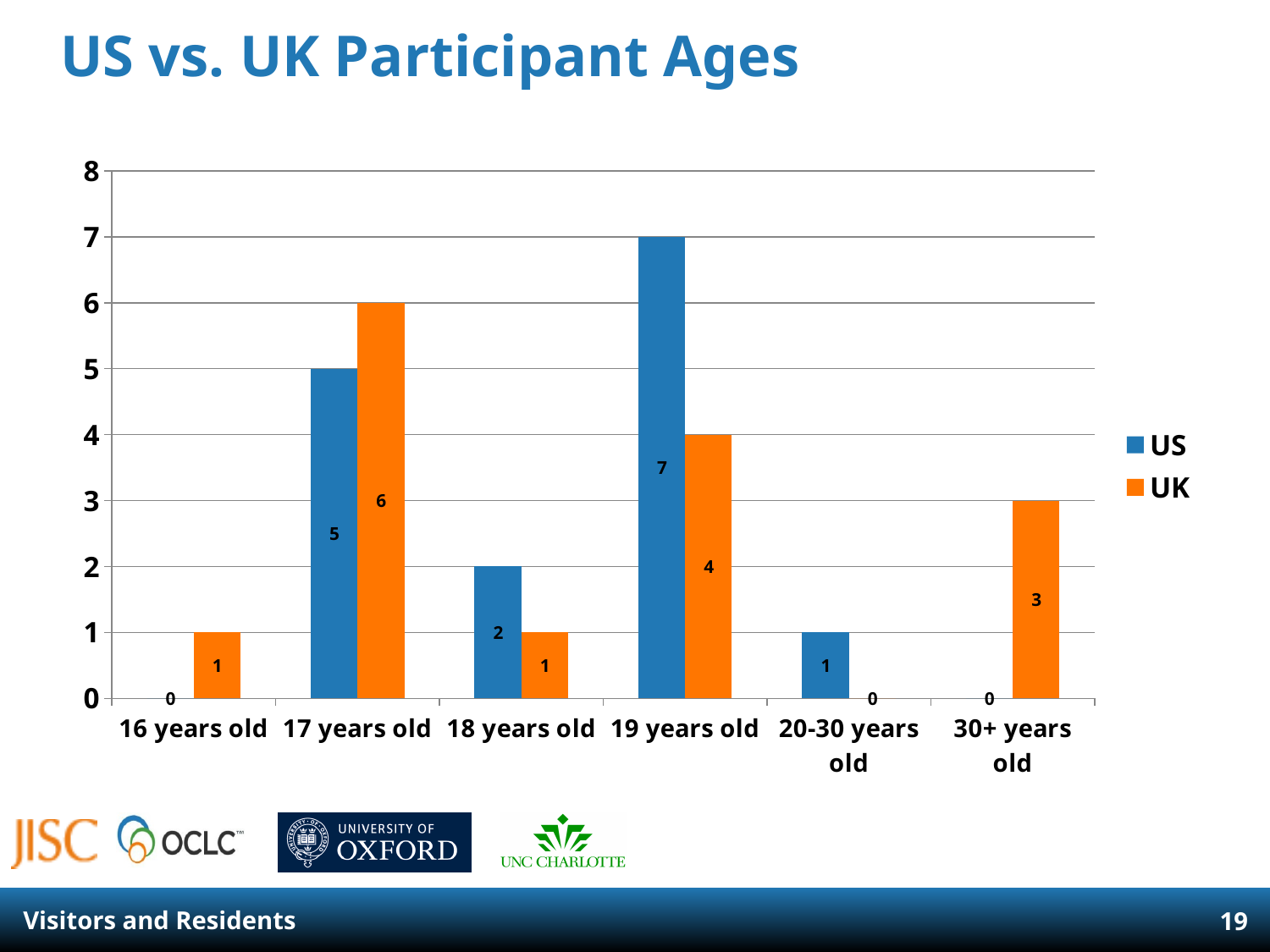
What kind of chart is shown on the slide? Bar chart What is the UK value for 17 years old? 6 What is the US value for 16 years old? 0 How many series does the legend list? 2 What is the title of the chart? US vs. UK Participant Ages What is the difference between the US and UK values for 19 years old? 3 Which age category has the highest UK value? 17 years old Which is larger for 17 years old, the US value or the UK value? UK What is the US value for 19 years old? 7 Which age category has the highest US value? 19 years old What is the UK value for 30+ years old? 3 How many age categories are shown on the x axis? 6